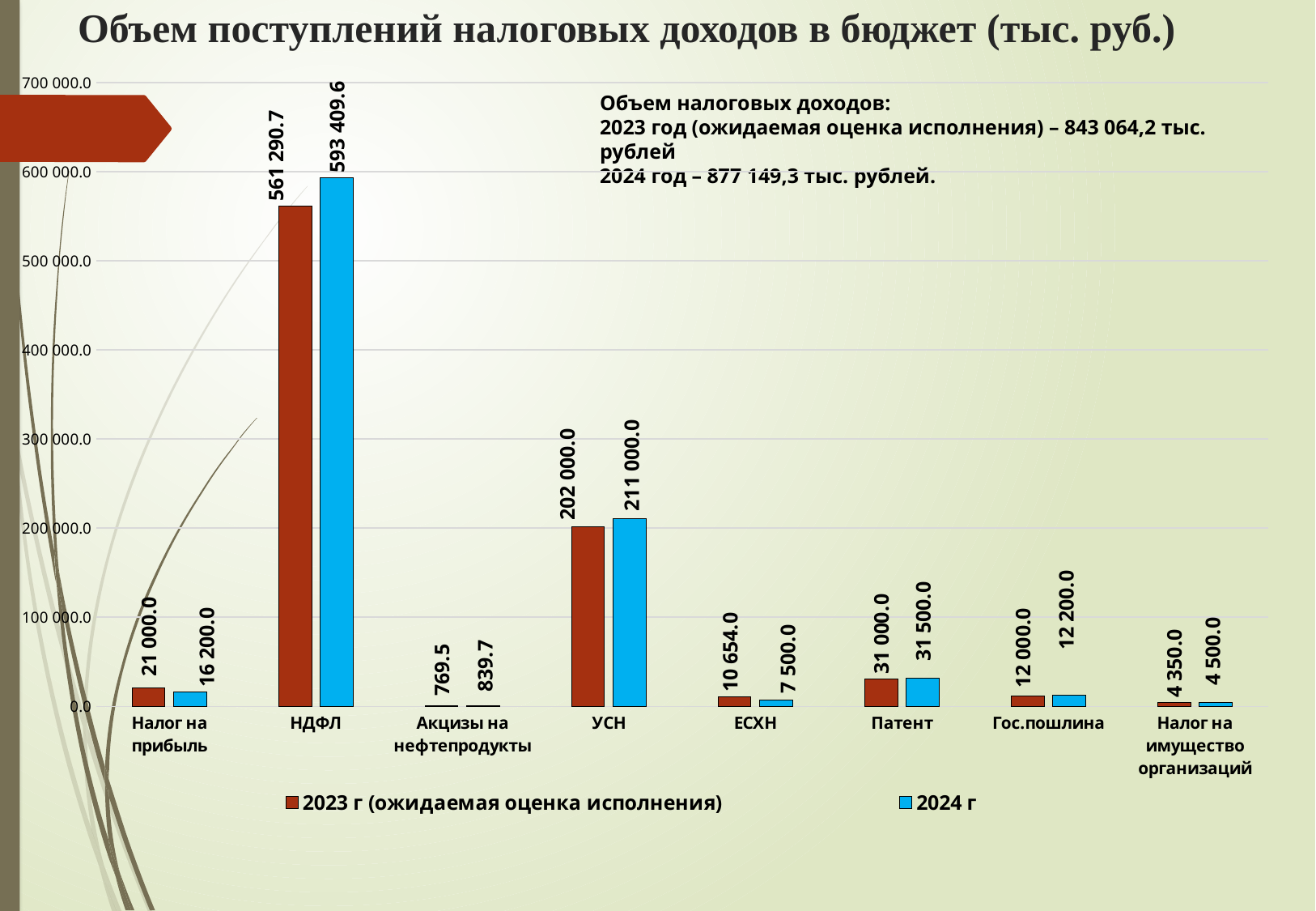
What is the difference between the 2024 г and 2023 г (ожидаемая оценка исполнения) values for УСН? 9 000.0 How many series does the legend list? 2 Which category has the lowest value in the 2023 г (ожидаемая оценка исполнения) series? Акцизы на нефтепродукты How many categories are shown on the x axis? 8 What is the title of the chart? Объем поступлений налоговых доходов в бюджет (тыс. руб.) What is the value for УСН in the 2023 г (ожидаемая оценка исполнения) series? 202 000.0 What is the value for ЕСХН in the 2023 г (ожидаемая оценка исполнения) series? 10 654.0 What is the value for НДФЛ in the 2024 г series? 593 409.6 What kind of chart is shown on the slide? Bar chart Which category has the highest value in the 2024 г series? НДФЛ Which is larger for Налог на прибыль: the 2023 г (ожидаемая оценка исполнения) value or the 2024 г value? 2023 г (ожидаемая оценка исполнения) What is the value for Акцизы на нефтепродукты in the 2024 г series? 839.7